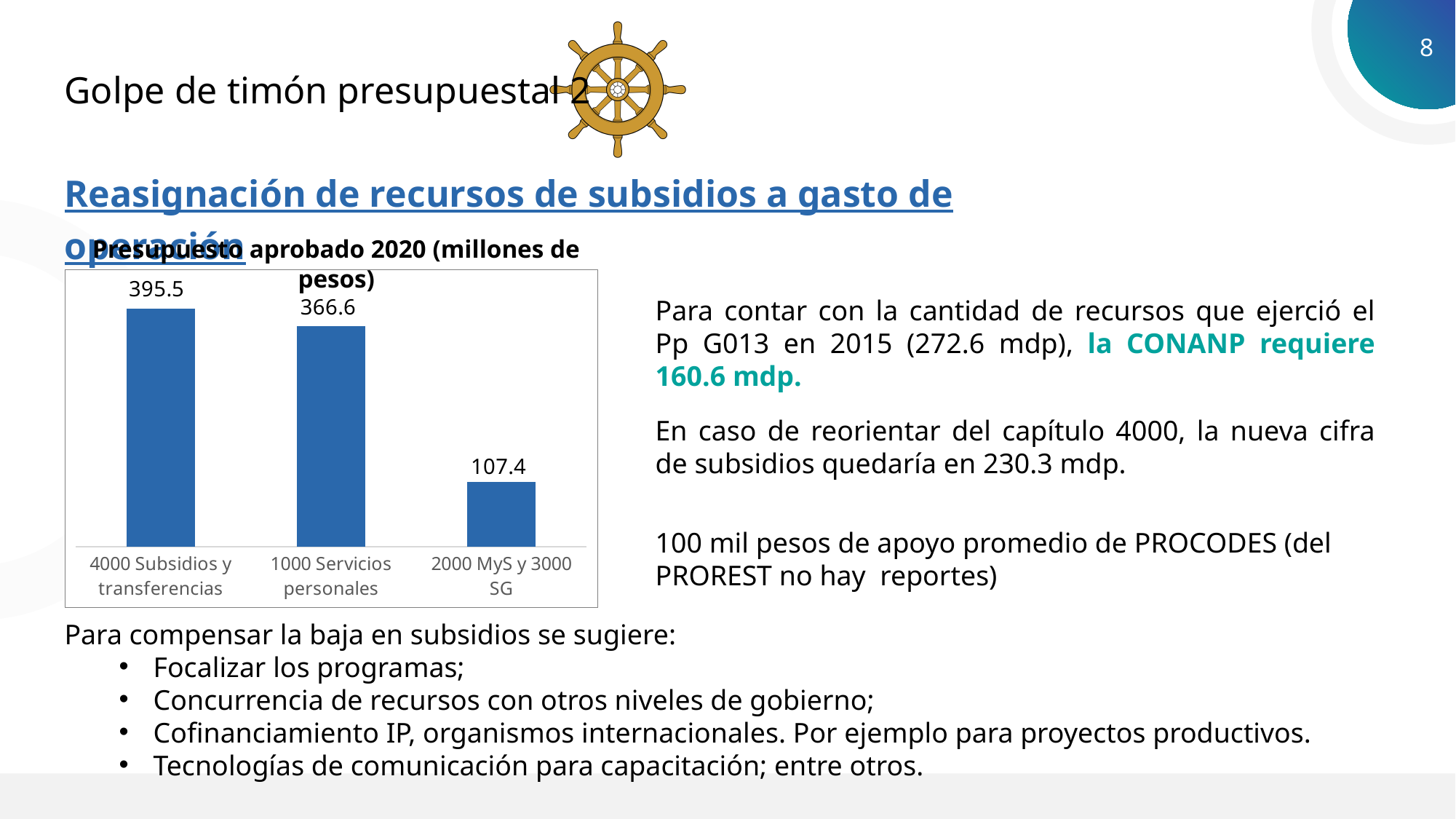
What is the value for 2000 MyS y 3000 SG? 107.4 Which category has the lowest value? 2000 MyS y 3000 SG What is the value for 1000 Servicios personales? 366.6 Which is larger, the value for 1000 Servicios personales or the value for 2000 MyS y 3000 SG? 1000 Servicios personales What is the title of the chart? Presupuesto aprobado 2020 (millones de pesos) What is the difference between the values for 1000 Servicios personales and 2000 MyS y 3000 SG? 259.2 What is the difference between the values for 4000 Subsidios y transferencias and 1000 Servicios personales? 28.9 Do the values rise or fall from left to right across the categories? Fall Which category has the highest value? 4000 Subsidios y transferencias What is the value for 4000 Subsidios y transferencias? 395.5 How many categories are shown in the chart? 3 What kind of chart is shown on the slide? Bar chart